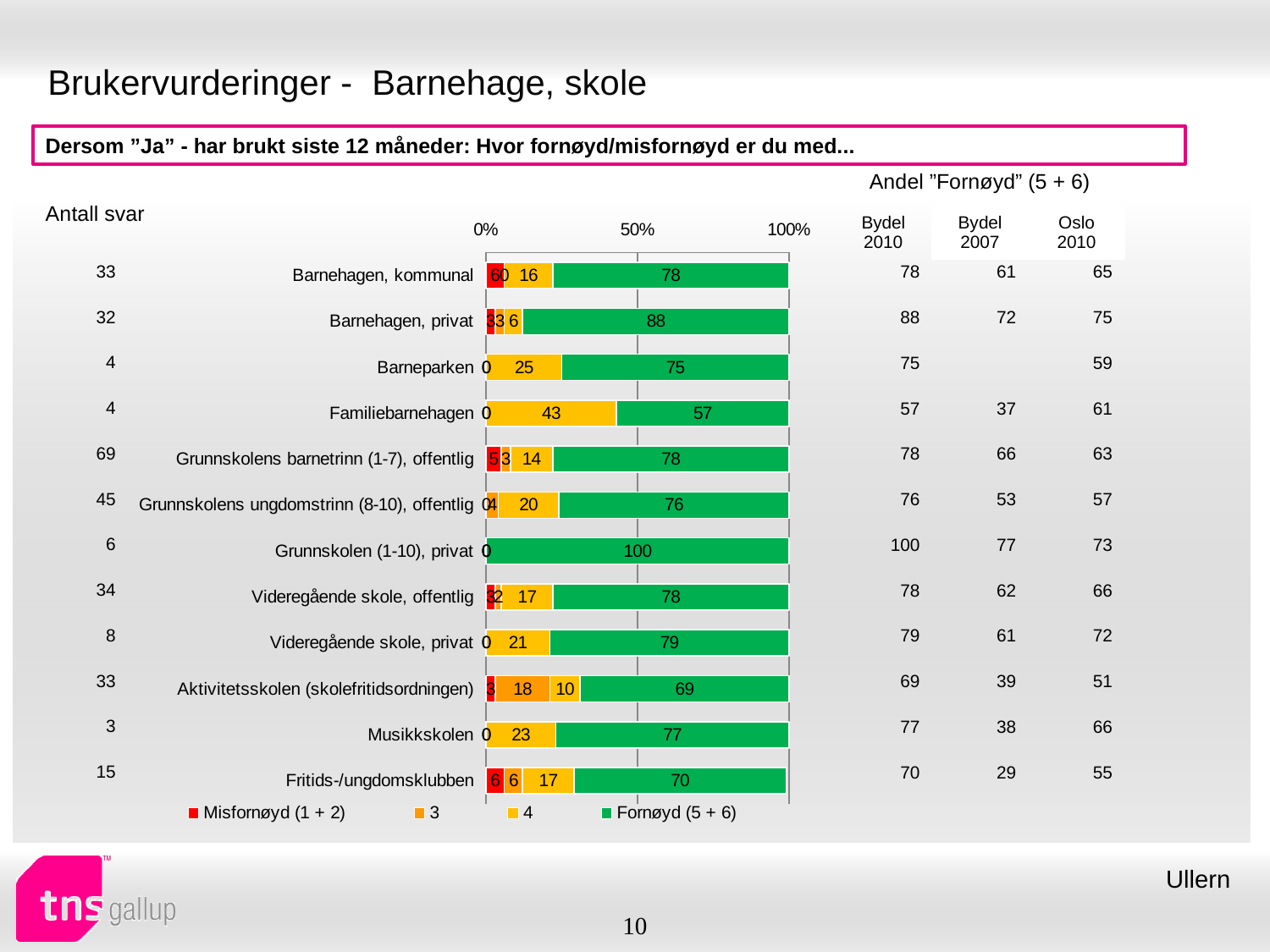
What type of chart is shown on the slide? bar chart How many series does the chart legend list? 4 How many categories are plotted in the chart? 12 What is the Fornøyd (5 + 6) value for Barnehagen, privat? 88 Which category has the highest Fornøyd (5 + 6) value? Grunnskolen (1-10), privat What is the value of series 4 for Familiebarnehagen? 43 Is the Fornøyd (5 + 6) value for Familiebarnehagen greater or less than 50%? greater What is the Fornøyd (5 + 6) value for Familiebarnehagen? 57 What colour represents the Fornøyd (5 + 6) series in the chart? green What is the difference between the Fornøyd (5 + 6) values for Barnehagen, privat and Aktivitetsskolen (skolefritidsordningen)? 19 Which category has the lowest Fornøyd (5 + 6) value? Familiebarnehagen Which has a larger Fornøyd (5 + 6) value, Musikkskolen or Fritids-/ungdomsklubben? Musikkskolen